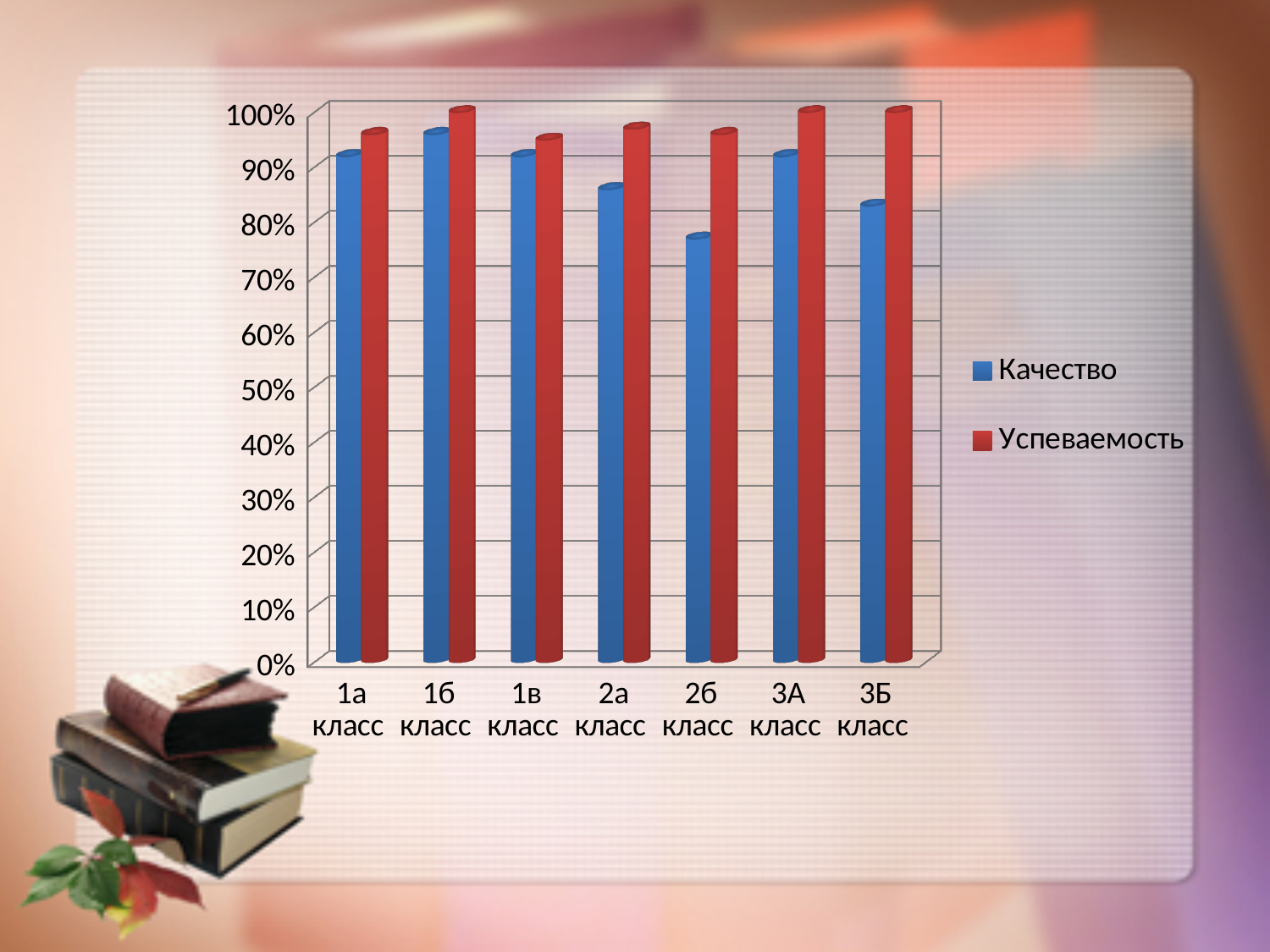
Is the Качество value for 1б класс greater or less than 90%? greater Which class has the highest value for Качество? 1б класс What kind of chart is shown on the slide? bar chart Is the Успеваемость value for 1а класс greater or less than 90%? greater What are the two series named in the legend? Качество and Успеваемость How many series does the legend list? 2 How many classes (categories) are shown on the x axis? 7 Which series is shown in blue? Качество Which class has the lowest value for Качество? 2б класс Is the Качество value for 3Б класс greater or less than 80%? greater Which is larger, the Качество value for 2а класс or for 2б класс? 2а класс